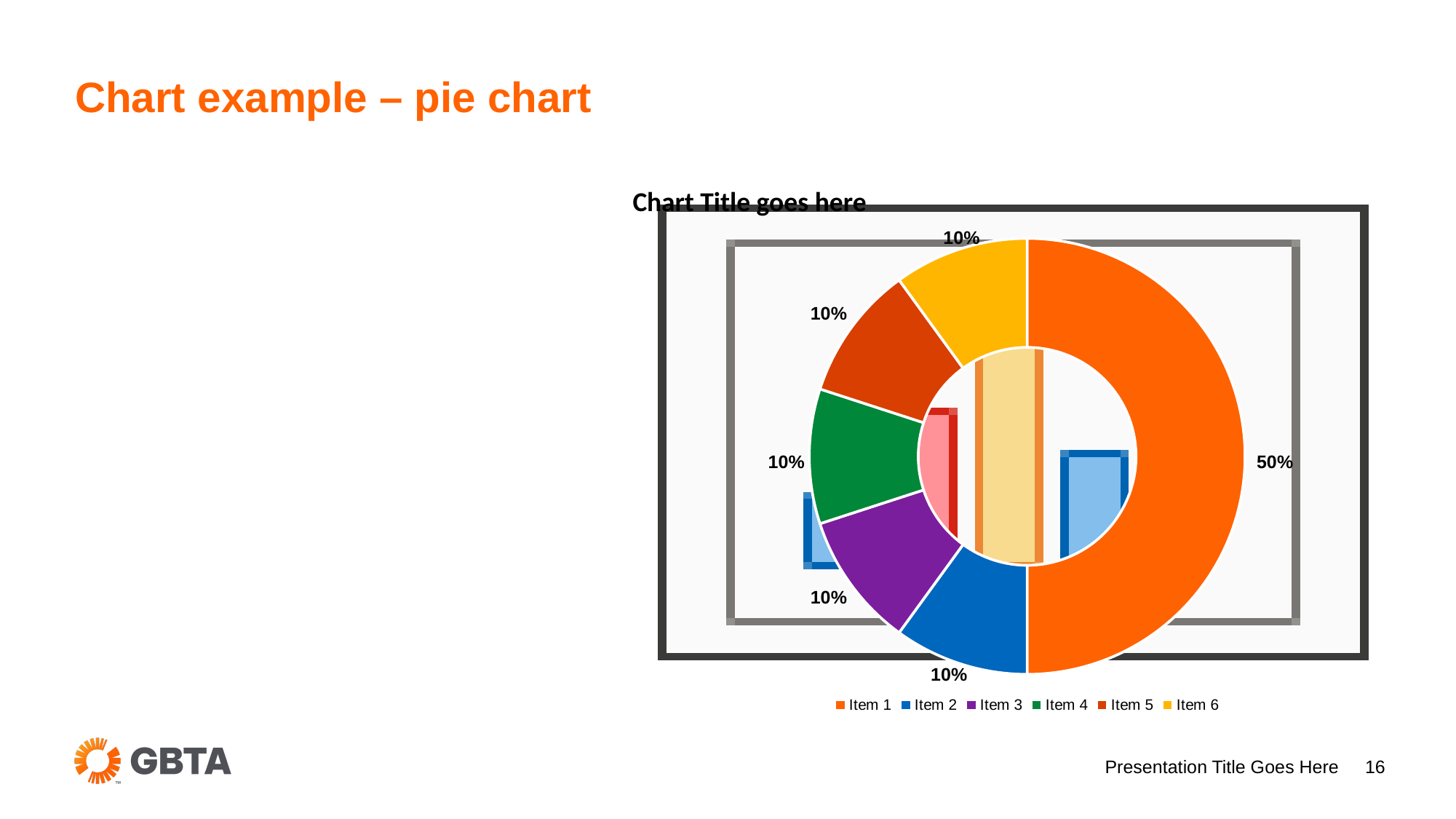
Which item has the largest slice of the pie? Item 1 How many slices does the pie chart have? 6 What is the title of the chart? Chart Title goes here What share of the pie does Item 4 represent? 10% What is the combined share of Item 2, Item 3 and Item 4? 30% What share of the pie does Item 6 represent? 10% How many entries does the legend list? 6 What is the difference between the share for Item 1 and the share for Item 2? 40% What kind of chart is shown on the slide? Pie chart What colour is the slice for Item 4 in the pie chart? Green Which is larger, the slice for Item 1 or the slice for Item 3? Item 1 What share of the pie does Item 1 represent? 50%